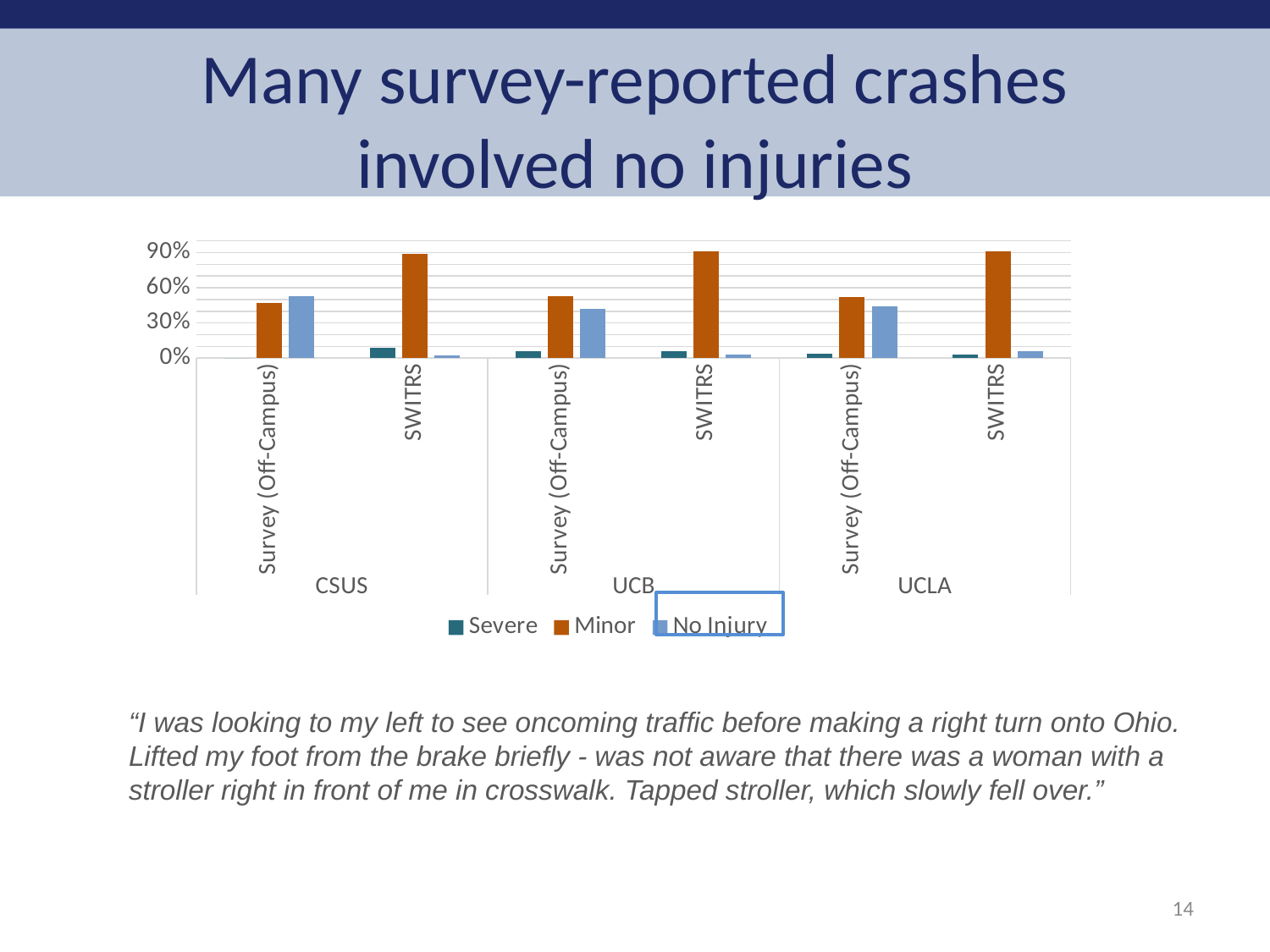
How many campus groups are shown along the x axis of the chart? 3 For UCB SWITRS, which is larger: the Minor value or the No Injury value? Minor What are the three series listed in the chart legend? Severe, Minor, No Injury How many series does the chart legend list? 3 Is the Minor value for CSUS SWITRS greater or less than 60%? greater What is the title of the slide containing the chart? Many survey-reported crashes involved no injuries For UCLA SWITRS, which series has the highest value? Minor What kind of chart is shown on the slide? bar chart Is the No Injury value for UCB SWITRS greater or less than 30%? less Is the Severe value for CSUS SWITRS greater or less than 30%? less How many category groups of bars (Survey/SWITRS pairs across all campuses) are plotted in the chart? 6